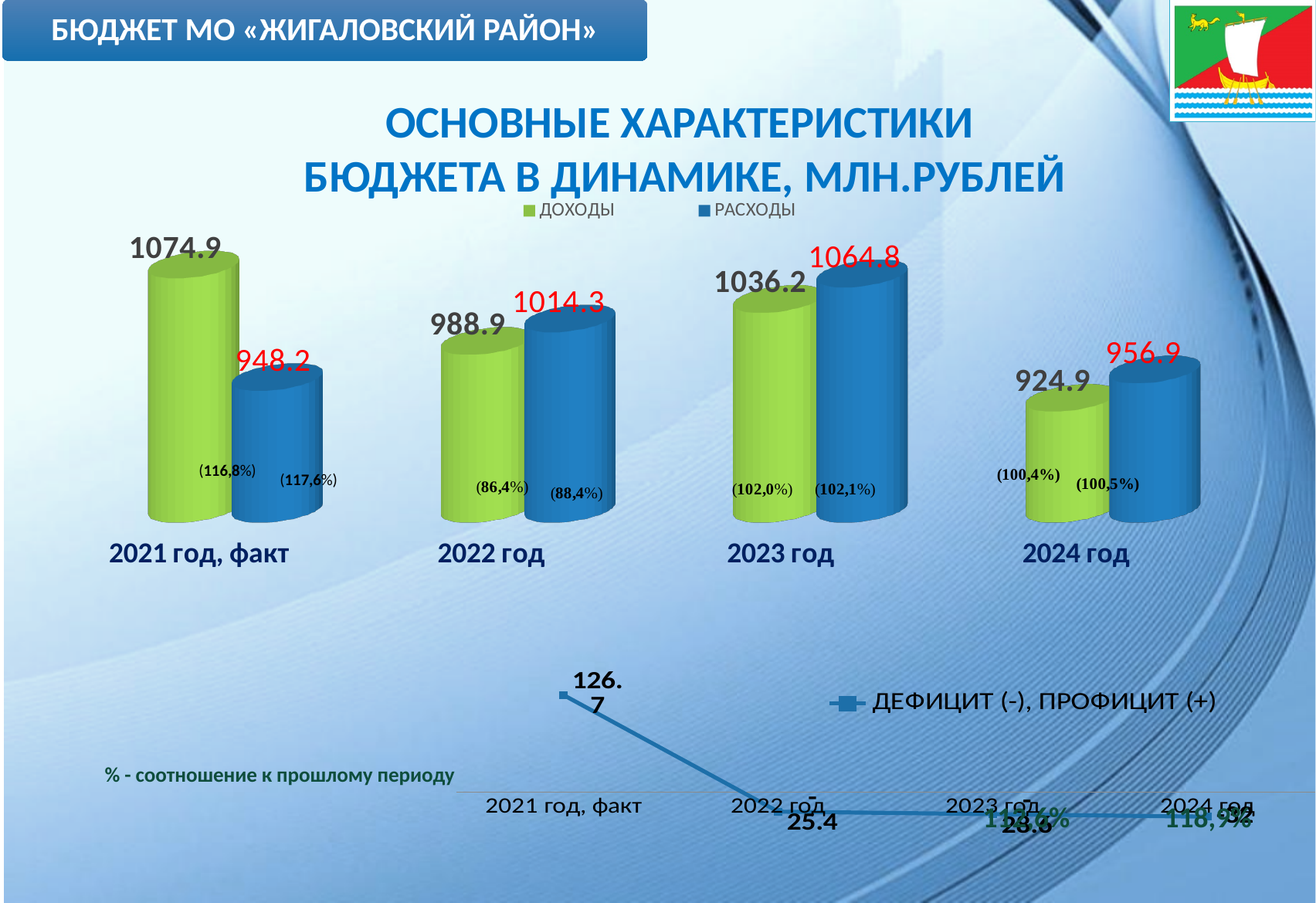
How many series does the legend of the bar chart list? 2 In the bar chart, what is the value of РАСХОДЫ for 2022 год? 1014.3 What type of chart is the lower chart titled ДЕФИЦИТ (-), ПРОФИЦИТ (+)? line chart In the bar chart, what is the value of ДОХОДЫ for 2024 год? 924.9 How many year categories are shown in the bar chart? 4 In the bar chart, which is larger for 2021 год, факт: ДОХОДЫ or РАСХОДЫ? ДОХОДЫ In the bar chart, which year has the lowest РАСХОДЫ value? 2021 год, факт In the line chart at the bottom, what is the value of ДЕФИЦИТ (-), ПРОФИЦИТ (+) for 2021 год, факт? 126.7 In the bar chart, what is the difference between РАСХОДЫ and ДОХОДЫ for 2023 год? 28.6 In the bar chart, which year has the highest ДОХОДЫ value? 2021 год, факт In the bar chart, what is the value of РАСХОДЫ for 2023 год? 1064.8 In the bar chart, what is the value of ДОХОДЫ for 2021 год, факт? 1074.9